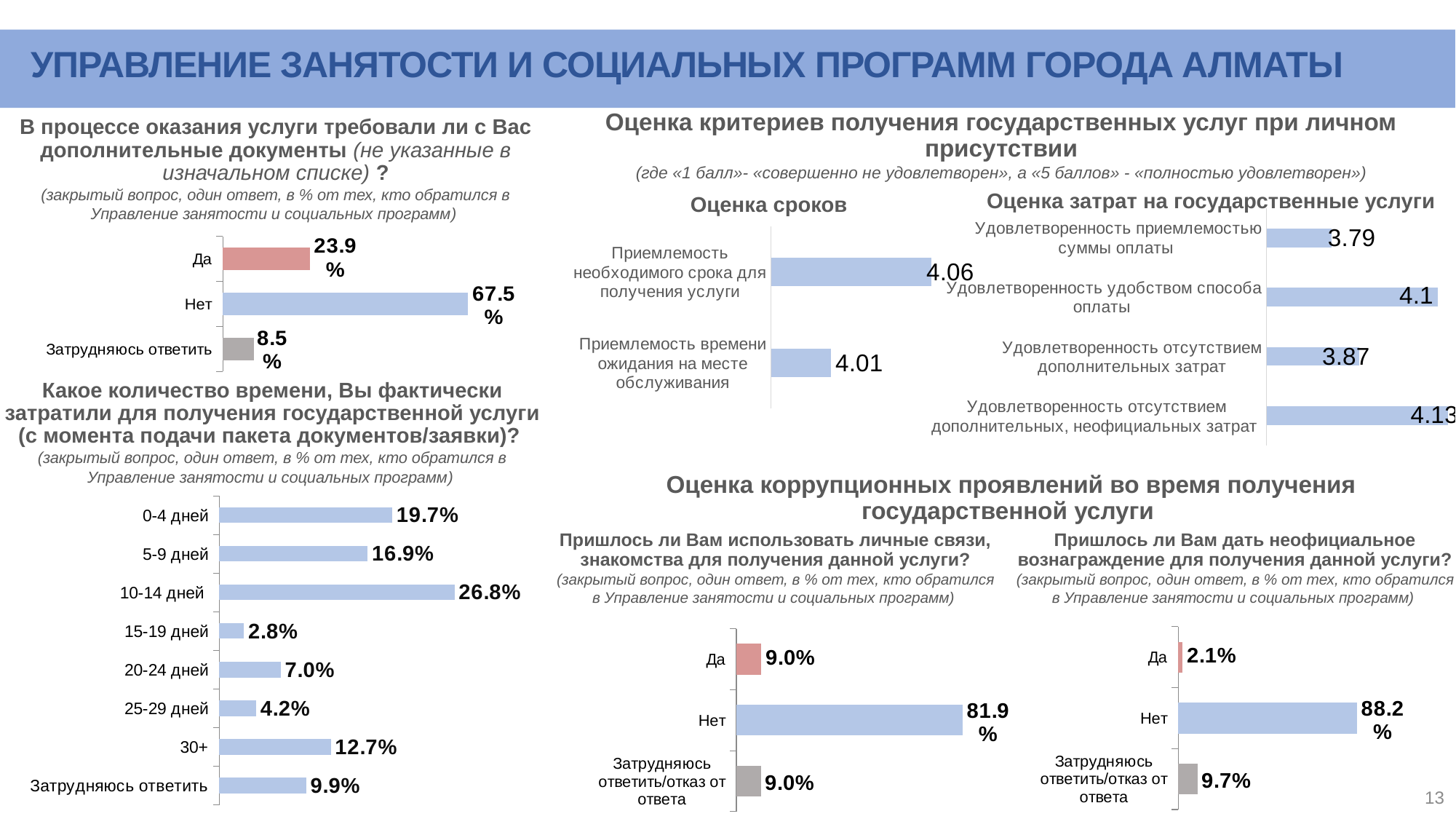
What type of chart is "Оценка сроков"? Bar chart In the chart "В процессе оказания услуги требовали ли с Вас дополнительные документы?", what is the difference between "Да" and "Затрудняюсь ответить"? 15.4% In the chart "Оценка сроков", what is the value for "Приемлемость времени ожидания на месте обслуживания"? 4.01 In the chart "Пришлось ли Вам использовать личные связи, знакомства для получения данной услуги?", what is the value for "Нет"? 81.9% In the chart "В процессе оказания услуги требовали ли с Вас дополнительные документы?", what is the value for "Нет"? 67.5% In the chart "Оценка затрат на государственные услуги", which category has the highest value? Удовлетворенность отсутствием дополнительных, неофициальных затрат In the chart "Оценка затрат на государственные услуги", what is the value for "Удовлетворенность приемлемостью суммы оплаты"? 3.79 In the chart "Пришлось ли Вам дать неофициальное вознаграждение для получения данной услуги?", which is larger: "Да" or "Затрудняюсь ответить/отказ от ответа"? Затрудняюсь ответить/отказ от ответа In the chart "Какое количество времени, Вы фактически затратили для получения государственной услуги", which category has the highest value? 10-14 дней In the chart "Какое количество времени, Вы фактически затратили для получения государственной услуги", what is the value for "30+"? 12.7% In the chart "Какое количество времени, Вы фактически затратили для получения государственной услуги", which category has the lowest value? 15-19 дней How many categories are shown in the chart "Какое количество времени, Вы фактически затратили для получения государственной услуги"? 8